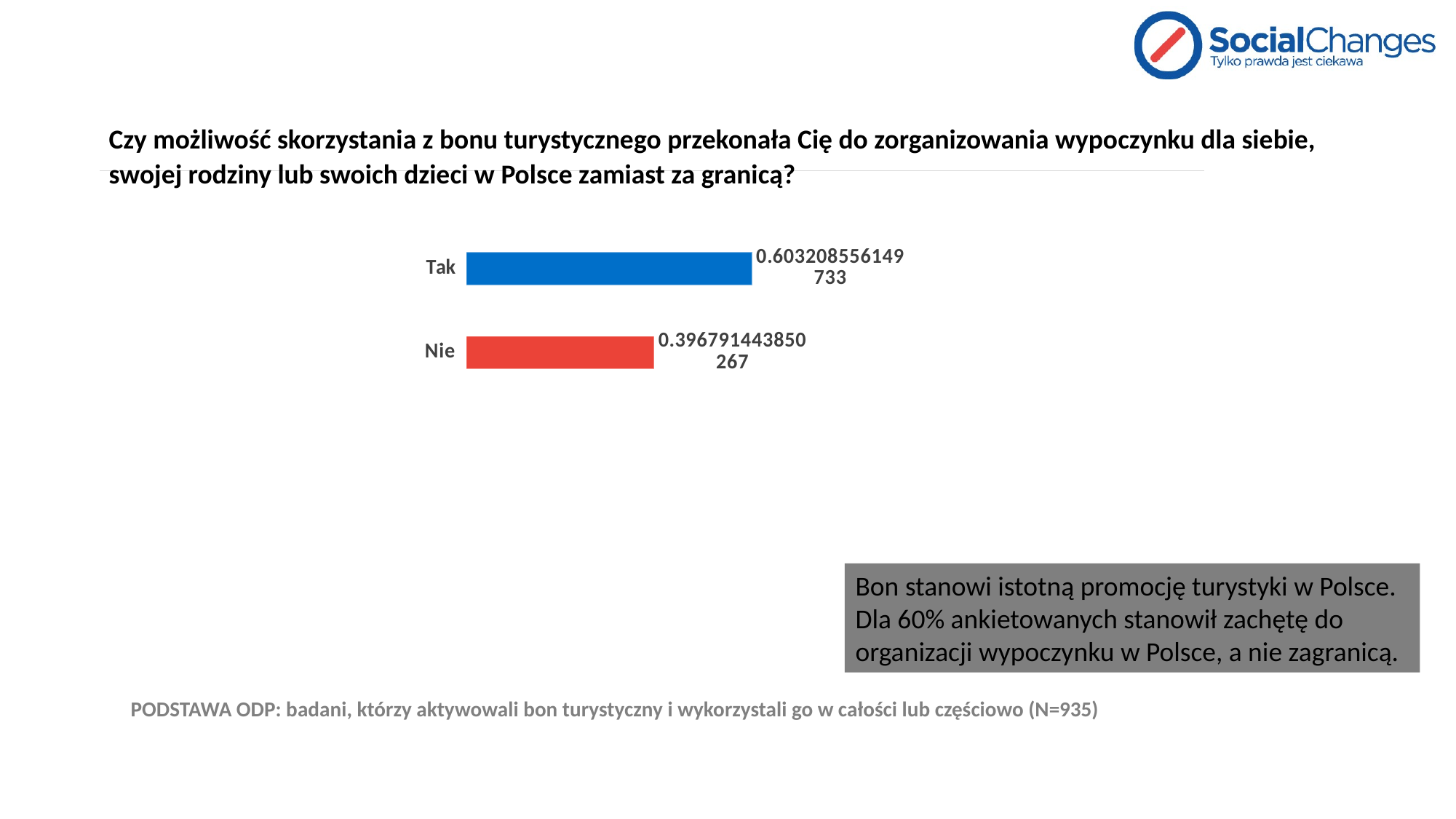
What is the value shown for Nie? 0.396791443850267 What colour is the bar for Nie? Red What is the value shown for Tak? 0.603208556149733 What kind of chart is shown on the slide? Bar chart Which category has the lowest value? Nie Which is larger, the value for Tak or the value for Nie? Tak How many categories are shown in the chart? 2 What colour is the bar for Tak? Blue Which category has the highest value? Tak What is the difference between the value for Tak and the value for Nie? 0.206417112299466